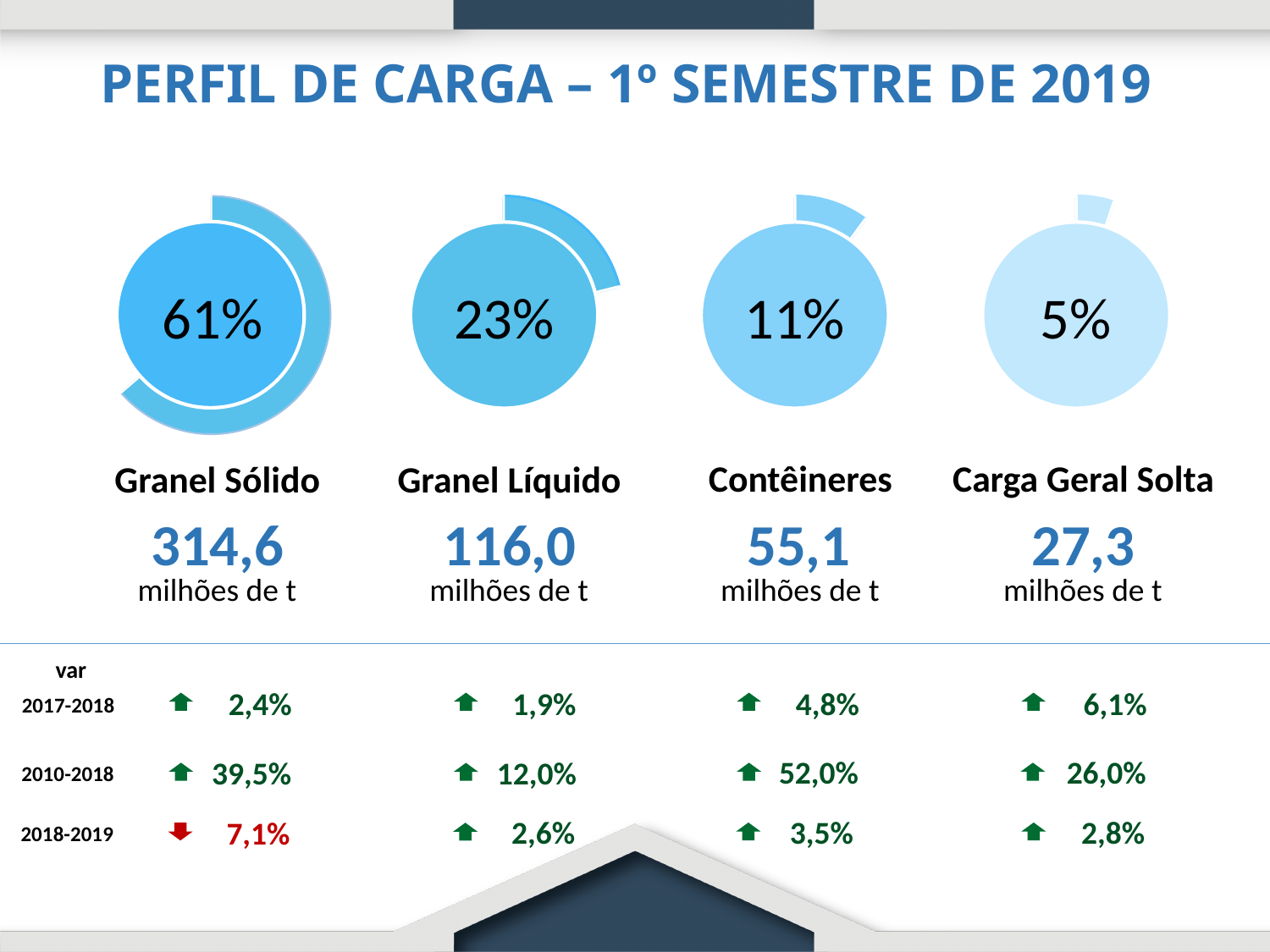
How many cargo categories are shown on the slide? 4 What is the difference in millions of tonnes between Granel Sólido and Carga Geral Solta? 287,3 milhões de t What is the 2010-2018 variation shown for Contêineres? 52,0% What is the difference in percentage points between the Granel Sólido share and the Granel Líquido share? 38% Which is larger in tonnage, Contêineres or Carga Geral Solta? Contêineres What kind of chart is used to show each category's share? Donut chart Which cargo category has the largest share? Granel Sólido Which category shows a decrease in the 2018-2019 variation? Granel Sólido How many millions of tonnes are shown for Granel Líquido? 116,0 milhões de t What percentage is shown for Contêineres? 11% What share of cargo does Granel Sólido represent in the 1st semester of 2019? 61% Which cargo category has the smallest share? Carga Geral Solta